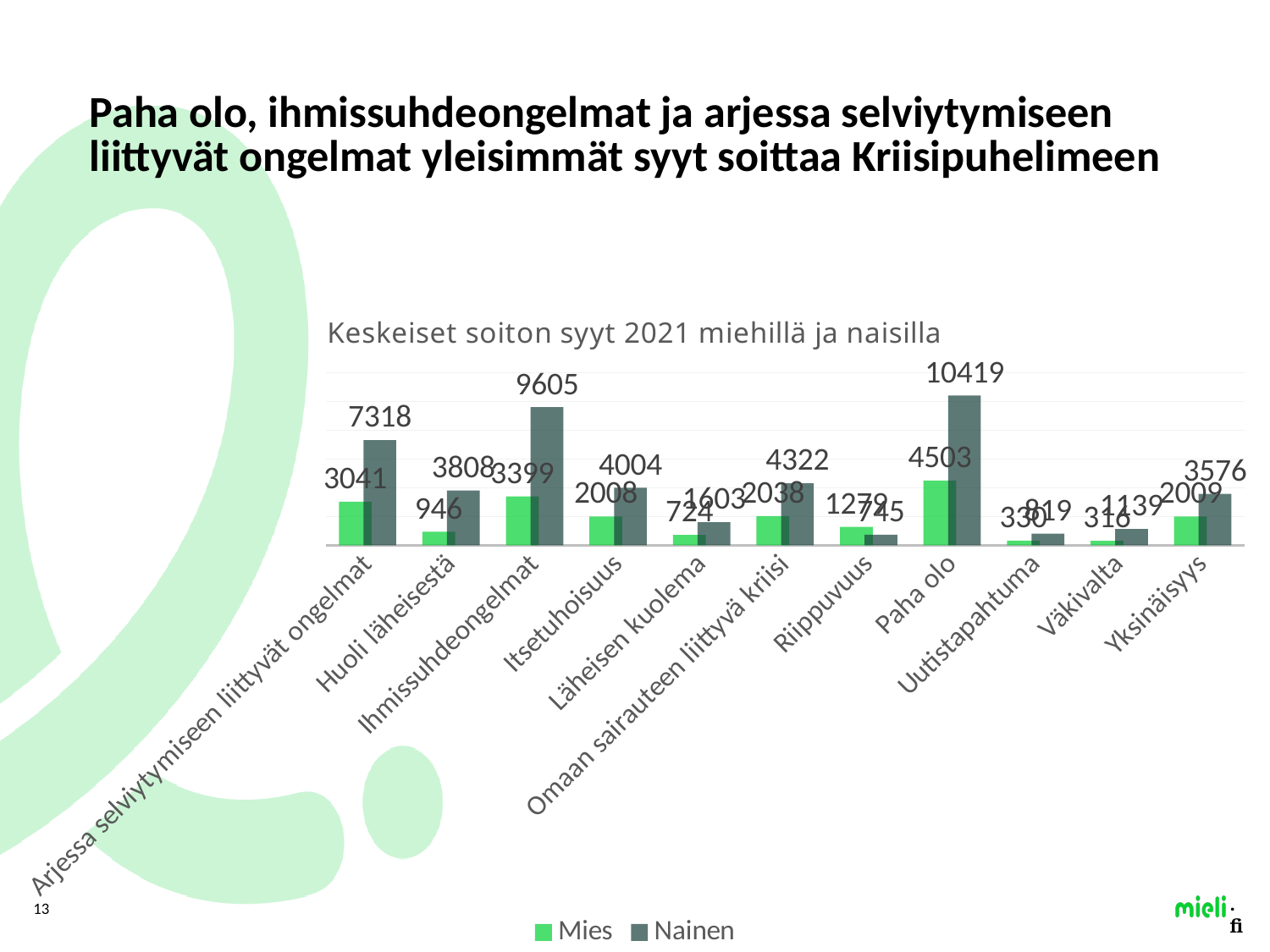
What is the difference between the Nainen and Mies values in the Paha olo category? 5916 What is the title of the chart? Keskeiset soiton syyt 2021 miehillä ja naisilla How many categories are shown on the x axis? 11 What is the value for Nainen in the Itsetuhoisuus category? 4004 Which category has the highest value for Nainen? Paha olo Which category has the lowest value for Mies? Väkivalta What kind of chart is shown on the slide? Bar chart What is the value for Nainen in the Paha olo category? 10419 How many series does the legend list? 2 What is the value for Mies in the Ihmissuhdeongelmat category? 3399 What is the value for Mies in the Huoli läheisestä category? 946 Which is larger in the Riippuvuus category, the Mies value or the Nainen value? Mies